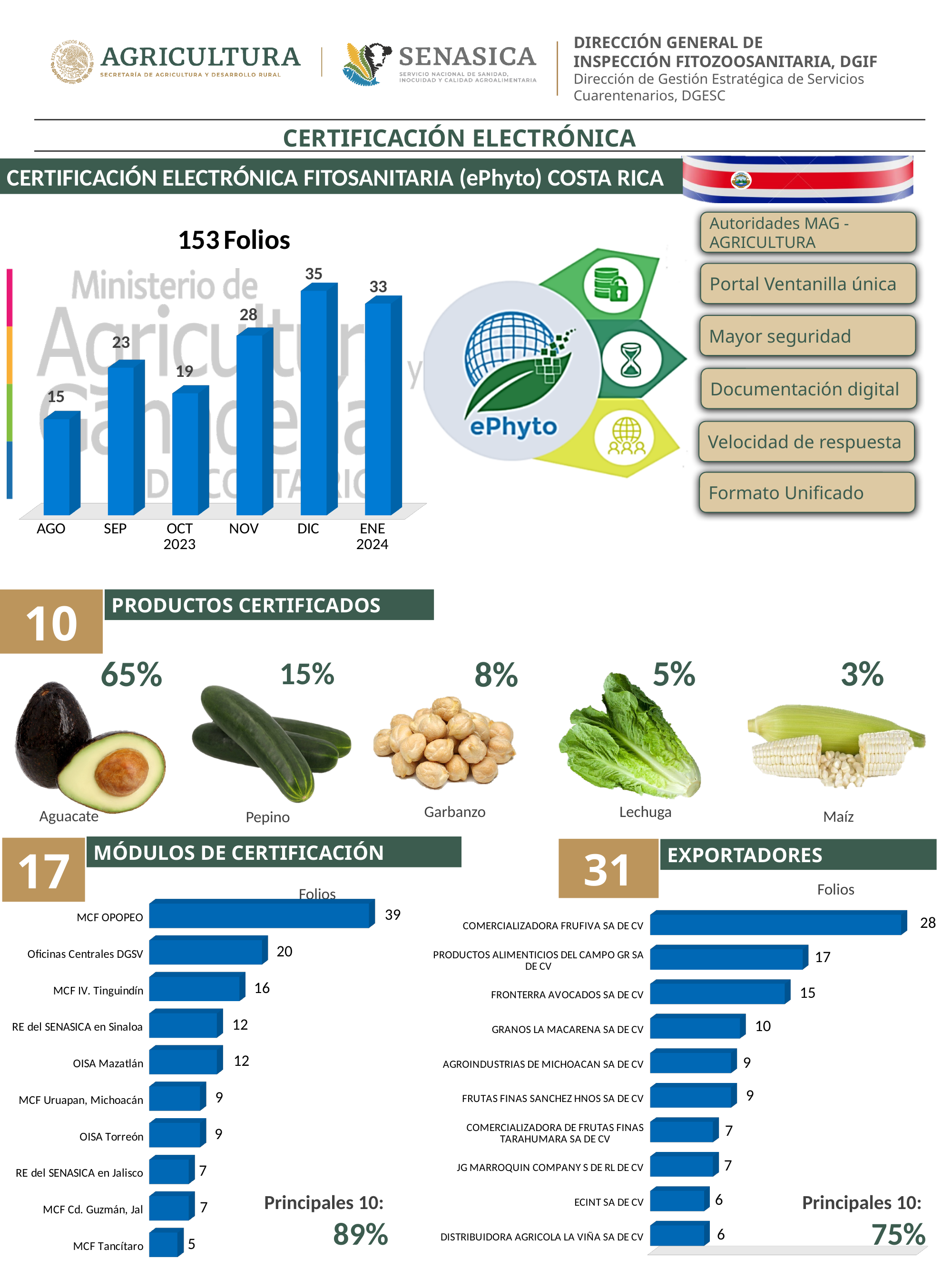
In the '153 Folios' monthly chart, how many months are plotted? 6 In the '153 Folios' monthly chart, which month has the lowest value? AGO What kind of chart is the 'Exportadores' chart? bar chart In the 'Exportadores' chart, which exporter has the lowest value among those shown? ECINT SA DE CV and DISTRIBUIDORA AGRICOLA LA VIÑA SA DE CV (6 each) In the 'Módulos de Certificación' chart, which is larger, MCF IV. Tinguindín or OISA Mazatlán? MCF IV. Tinguindín In the 'Módulos de Certificación' chart, what is the difference between MCF OPOPEO and MCF Tancítaro? 34 In the '153 Folios' monthly chart, what is the difference between the values for DIC and AGO? 20 In the 'Módulos de Certificación' chart, what is the value for Oficinas Centrales DGSV? 20 In the '153 Folios' monthly chart, what is the value for DIC? 35 In the 'Exportadores' chart, what is the value for FRONTERRA AVOCADOS SA DE CV? 15 In the 'Módulos de Certificación' chart, which module has the highest value? MCF OPOPEO In the '153 Folios' monthly chart, do the values rise or fall from AGO to DIC? rise